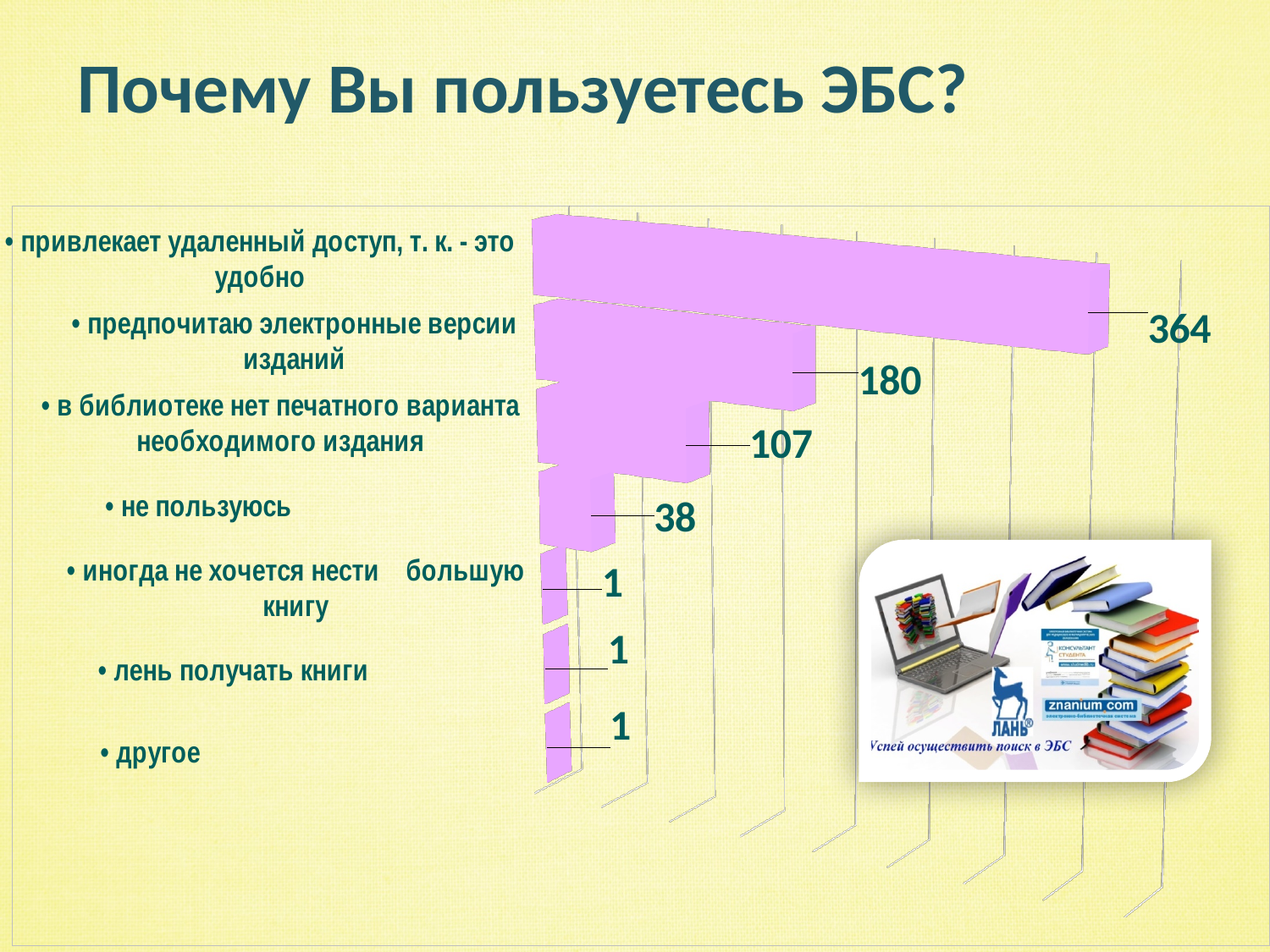
What value is shown for "в библиотеке нет печатного варианта необходимого издания"? 107 What is the difference between the values for "в библиотеке нет печатного варианта необходимого издания" and "не пользуюсь"? 69 How many categories are shown in the chart? 7 What is the difference between the values for "привлекает удаленный доступ, т. к. - это удобно" and "предпочитаю электронные версии изданий"? 184 What value is shown for "предпочитаю электронные версии изданий"? 180 What value is shown for "лень получать книги"? 1 What value is shown for "привлекает удаленный доступ, т. к. - это удобно"? 364 What value is shown for "не пользуюсь"? 38 What is the title of the slide? Почему Вы пользуетесь ЭБС? What kind of chart is shown on the slide? bar chart Which category has the highest value? привлекает удаленный доступ, т. к. - это удобно Which is larger, the value for "предпочитаю электронные версии изданий" or the value for "в библиотеке нет печатного варианта необходимого издания"? предпочитаю электронные версии изданий